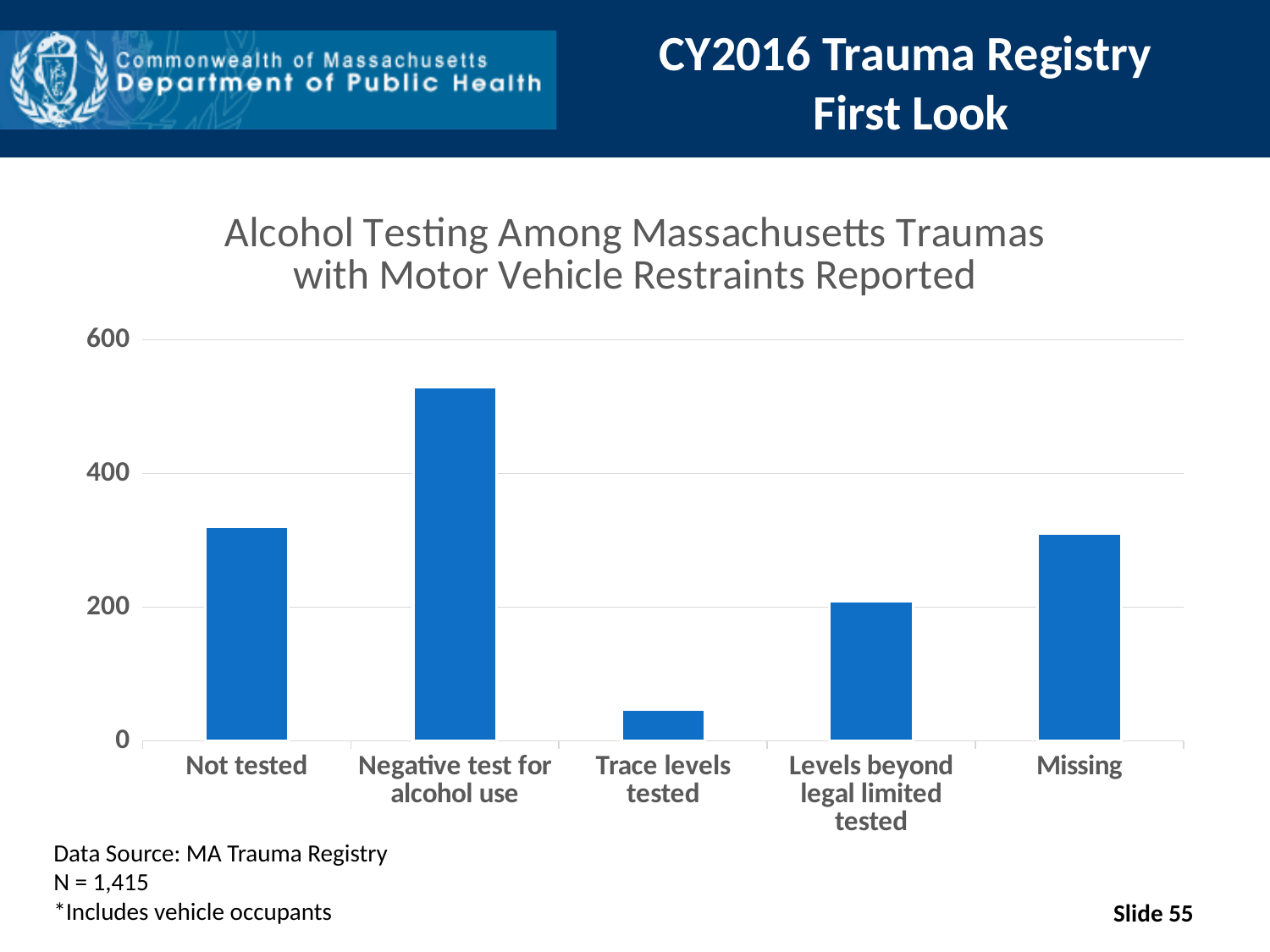
What is the title of the chart? Alcohol Testing Among Massachusetts Traumas with Motor Vehicle Restraints Reported Which category has the lowest value in the chart? Trace levels tested What is the highest value shown on the y axis of the chart? 600 Which is larger, the value for Negative test for alcohol use or the value for Missing? Negative test for alcohol use What kind of chart is shown on the slide? bar chart How many categories are shown on the x axis of the chart? 5 Which is larger, the value for Levels beyond legal limited tested or the value for Trace levels tested? Levels beyond legal limited tested Is the value for Missing greater or less than 200? greater Which category has the highest value in the chart? Negative test for alcohol use Is the value for Not tested greater or less than 400? less Is the value for Trace levels tested greater or less than 200? less